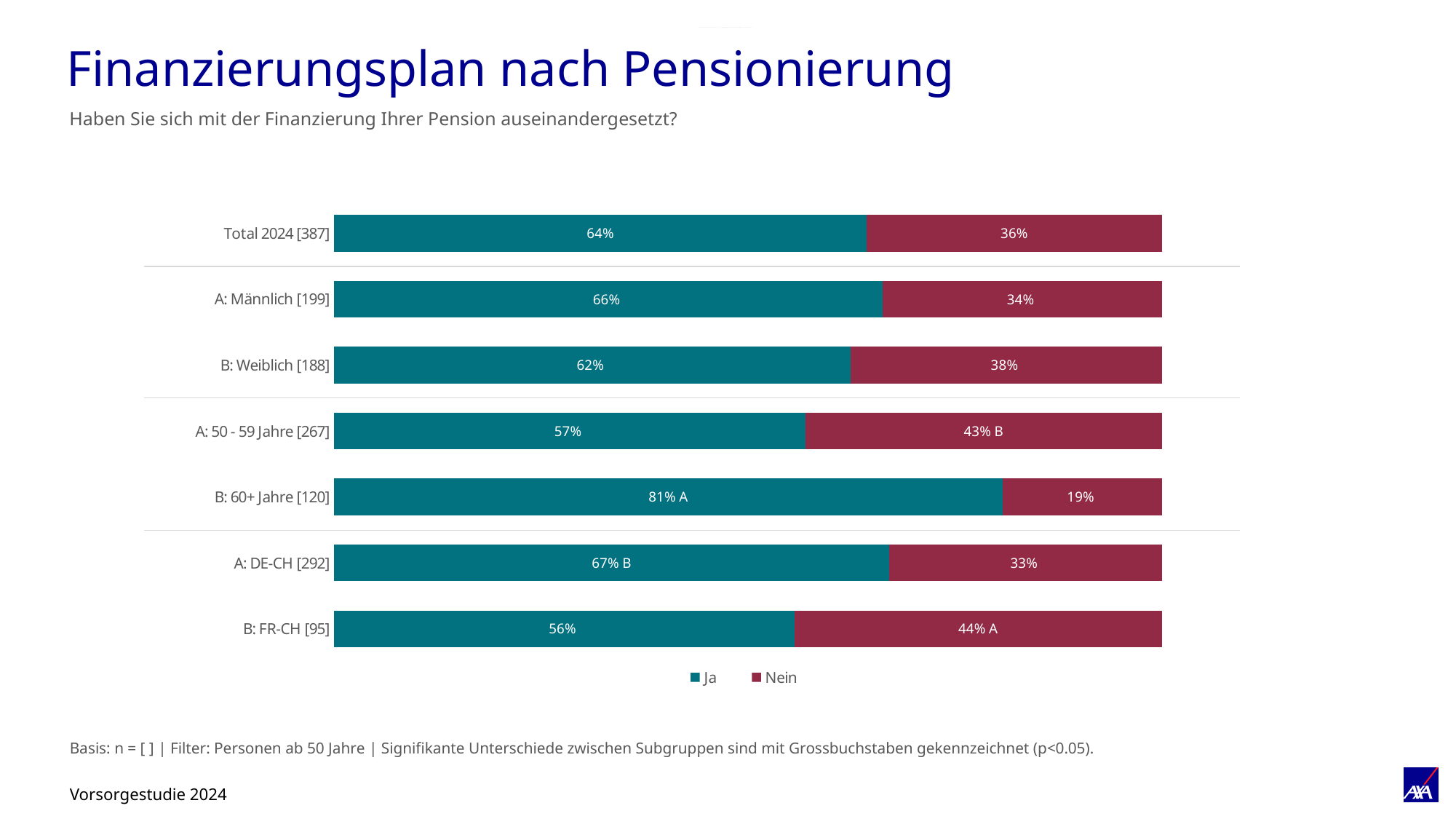
What is the 'Ja' value for Total 2024 [387]? 64% What is the total of the stacked bar for A: DE-CH [292]? 100% What is the difference between the 'Ja' values for A: Männlich [199] and B: Weiblich [188]? 4 percentage points What kind of chart is shown on the slide? Stacked horizontal bar chart Which category has the highest 'Ja' value? B: 60+ Jahre [120] How many series does the legend list? 2 Which has a larger 'Nein' value, A: 50 - 59 Jahre [267] or A: DE-CH [292]? A: 50 - 59 Jahre [267] Which category has the lowest 'Ja' value? B: FR-CH [95] What is the 'Ja' value for B: 60+ Jahre [120]? 81% What is the 'Nein' value for B: FR-CH [95]? 44% How many categories are shown in the chart? 7 What is the 'Nein' value for B: Weiblich [188]? 38%